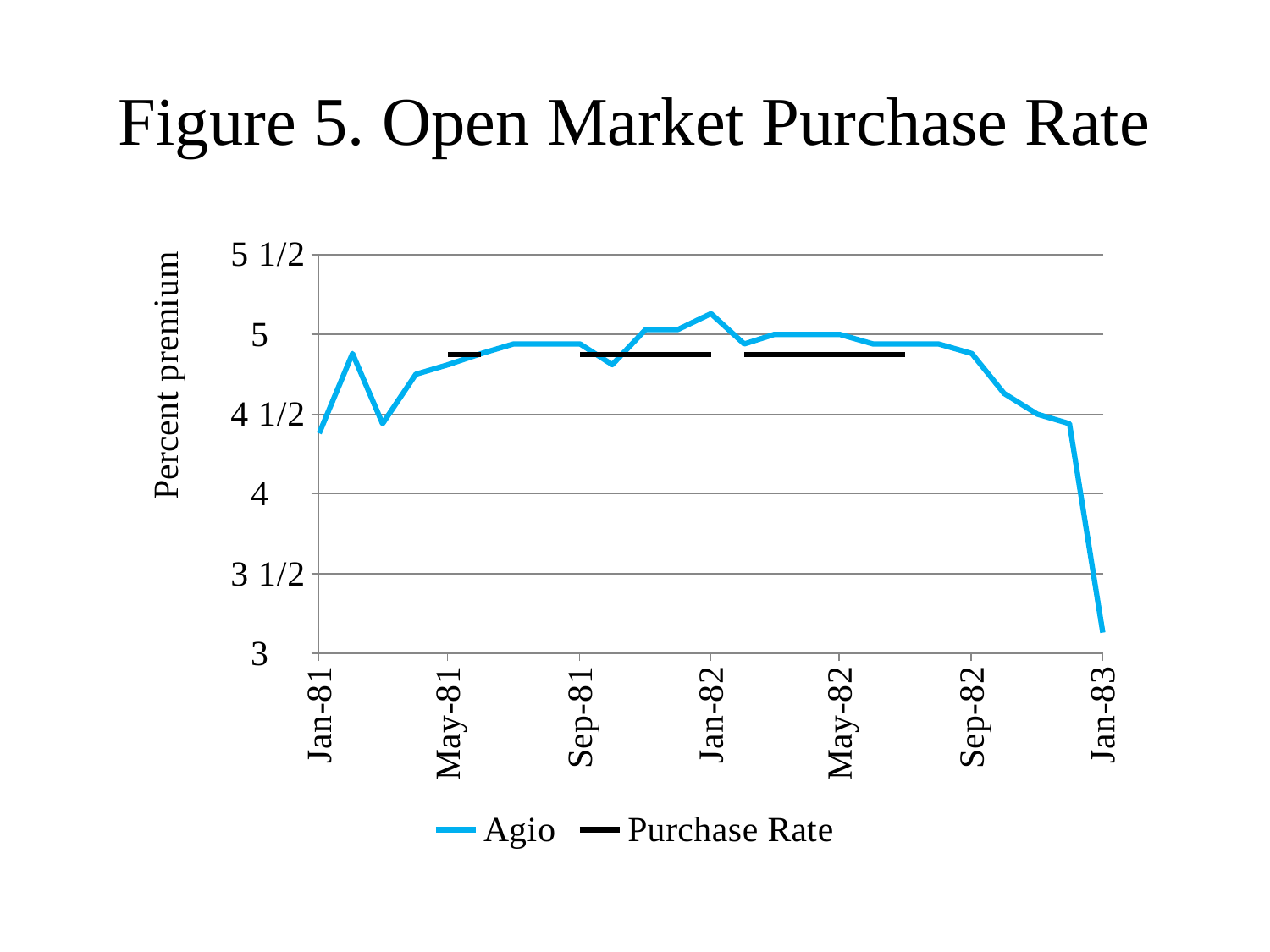
Is the Purchase Rate value greater or less than 5? less Is the Agio value at Jan-83 greater or less than 4? less What is the title of the chart? Figure 5. Open Market Purchase Rate Does the Agio line rise or fall between Sep-82 and Jan-83? fall What kind of chart is shown on the slide? line chart What is the label on the vertical axis? Percent premium How many date labels are shown on the x axis? 7 Is the Agio value at Sep-82 greater or less than 5? less At which labeled date on the x axis is the Agio value lowest? Jan-83 How many series does the legend list? 2